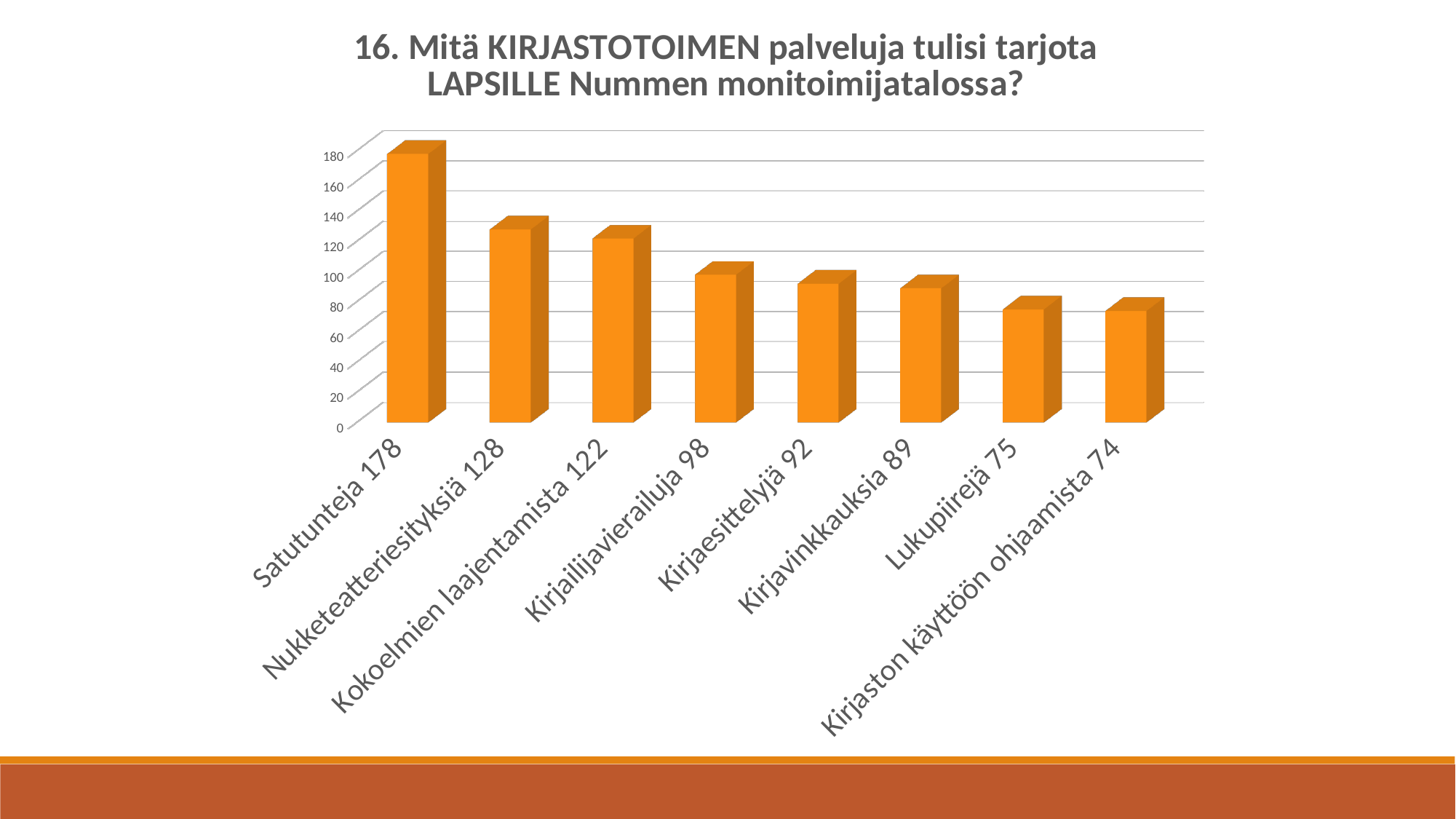
What value is shown for Kirjailijavierailuja? 98 What value is shown for Lukupiirejä? 75 What kind of chart is shown on the slide? Bar chart Do the values rise or fall from left to right along the x axis? Fall Which category has the lowest value? Kirjaston käyttöön ohjaamista What is the difference between the values for Kirjaesittelyjä and Kirjavinkkauksia? 3 Which is larger, the value for Kokoelmien laajentamista or the value for Kirjailijavierailuja? Kokoelmien laajentamista What is the difference between the values for Satutunteja and Nukketeatteriesityksiä? 50 Which category has the highest value? Satutunteja What value is shown for Satutunteja? 178 How many categories are shown in the chart? 8 Is the value for Nukketeatteriesityksiä greater or less than 120? greater